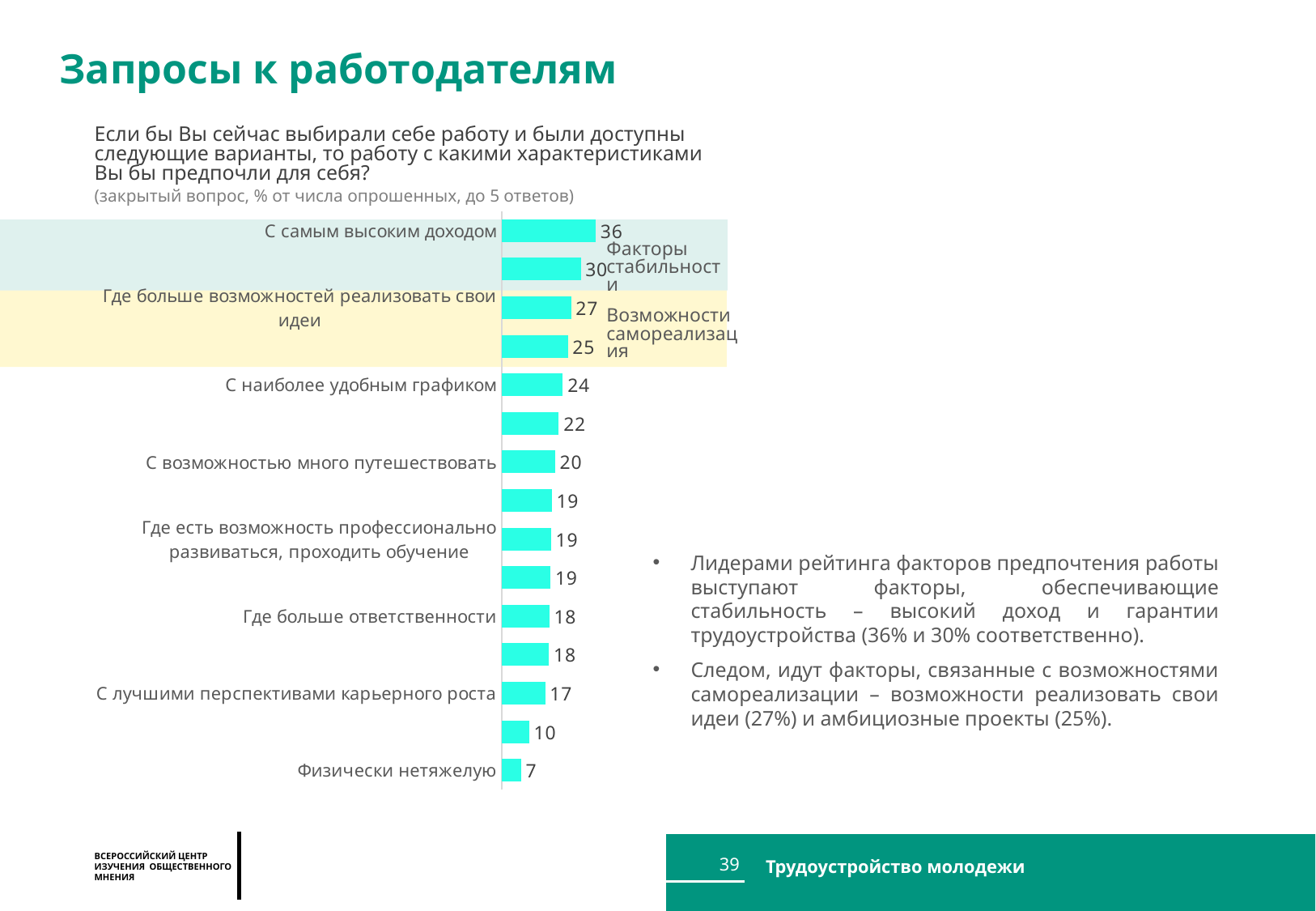
What value is shown for "С самым высоким доходом"? 36 What value is shown for "Где больше возможностей реализовать свои идеи"? 27 What is the difference between the values for "С самым высоким доходом" and "С наиболее удобным графиком"? 12 What value is shown for "Физически нетяжелую"? 7 Which category has the highest value? С самым высоким доходом What kind of chart is shown on the slide? Bar chart What value is shown for "С наиболее удобным графиком"? 24 What is the title of the slide? Запросы к работодателям Which is larger: the value for "С возможностью много путешествовать" or for "Где больше ответственности"? С возможностью много путешествовать Do the bar values increase or decrease from the top of the chart to the bottom? Decrease Which category has the lowest value? Физически нетяжелую How many bars are plotted in the chart? 15